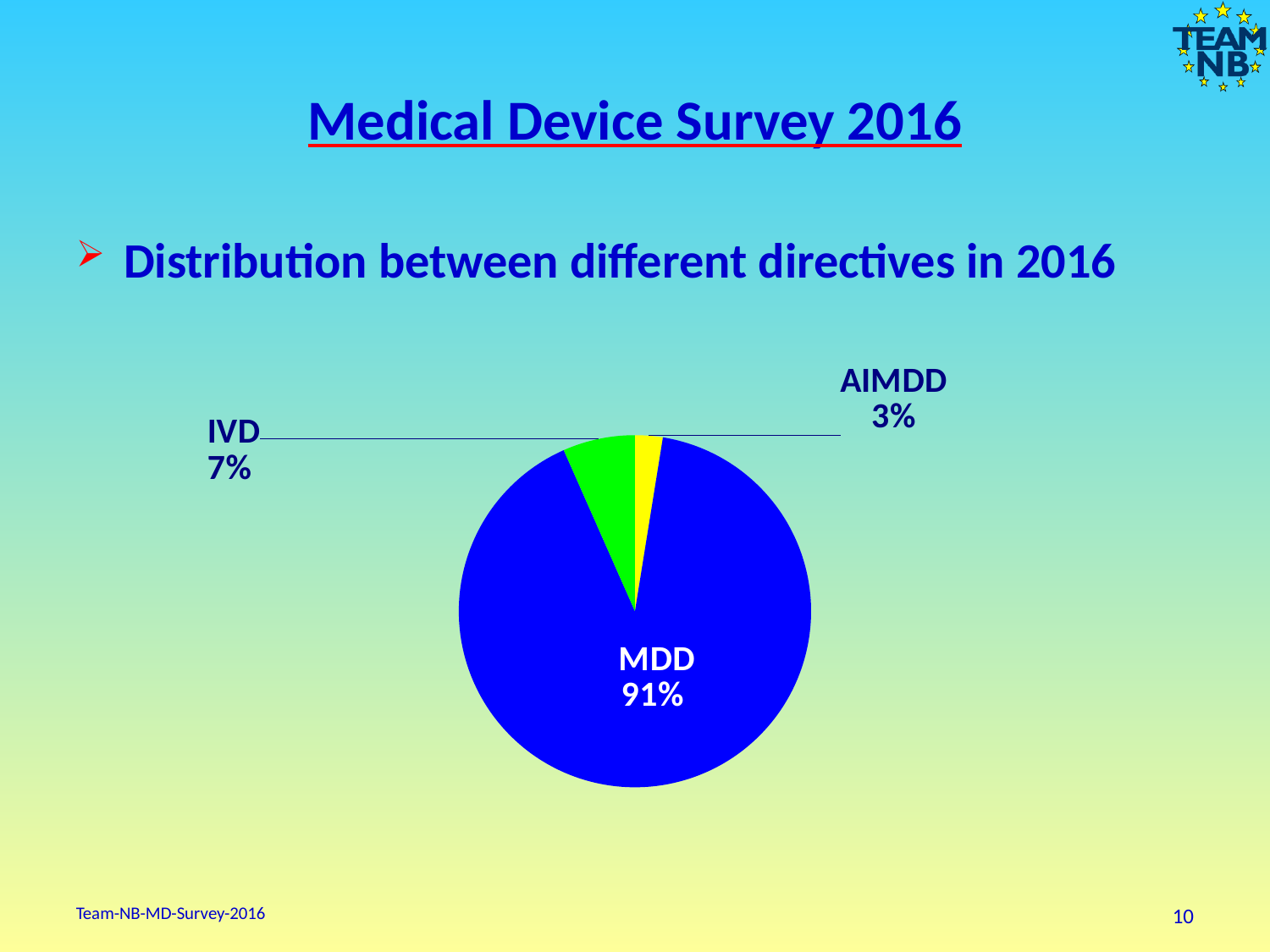
What is the difference in percentage points between the MDD share and the IVD share? 84 What is the difference in percentage points between the IVD share and the AIMDD share? 4 Which has a larger share, IVD or AIMDD? IVD What share of the pie does AIMDD account for? 3% What colour is the MDD slice of the pie? Blue What share of the pie does IVD account for? 7% How many slices does the pie chart have? 3 What kind of chart is shown on the slide? Pie chart What colour is the IVD slice of the pie? Green Which directive has the largest share of the pie? MDD What share of the pie does MDD account for? 91% Which directive has the smallest share of the pie? AIMDD